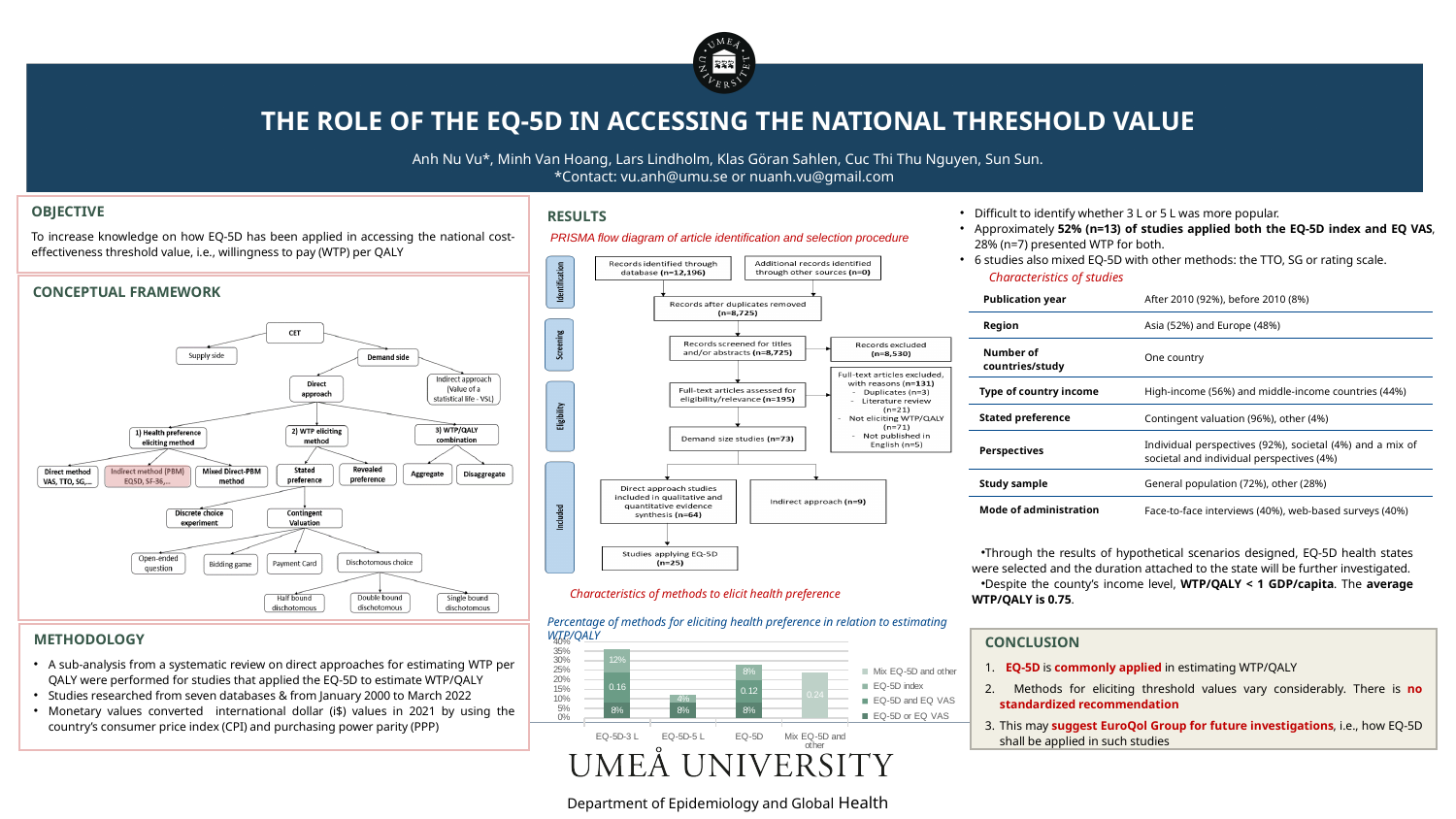
What is the highest value shown on the y axis of the 'Percentage of methods for eliciting health preference' chart? 40% In the 'Percentage of methods for eliciting health preference' chart, is the total of the 'EQ-5D-3 L' bar greater or less than 30%? greater How many series does the legend of the 'Percentage of methods for eliciting health preference' chart list? 4 In the 'Percentage of methods for eliciting health preference' chart, what value is printed on the top segment of the 'EQ-5D-3 L' bar? 12% How many categories are shown on the x axis of the 'Percentage of methods for eliciting health preference' chart? 4 In the 'Percentage of methods for eliciting health preference' chart, which category has the shortest stacked bar? EQ-5D-5 L In the 'Percentage of methods for eliciting health preference' chart, what value is printed on the bottom segment of the 'EQ-5D-3 L' bar? 8% What kind of chart is shown at the bottom of the slide under 'Percentage of methods for eliciting health preference in relation to estimating WTP/QALY'? Stacked bar chart In the 'Percentage of methods for eliciting health preference' chart, what value is printed on the 'Mix EQ-5D and other' bar? 0.24 In the 'Percentage of methods for eliciting health preference' chart, is the 'EQ-5D-5 L' bar taller or shorter than the 'EQ-5D' bar? shorter In the 'Percentage of methods for eliciting health preference' chart, what is the total of the 'EQ-5D-5 L' stacked bar? 12% In the 'Percentage of methods for eliciting health preference' chart, which category has the tallest stacked bar? EQ-5D-3 L